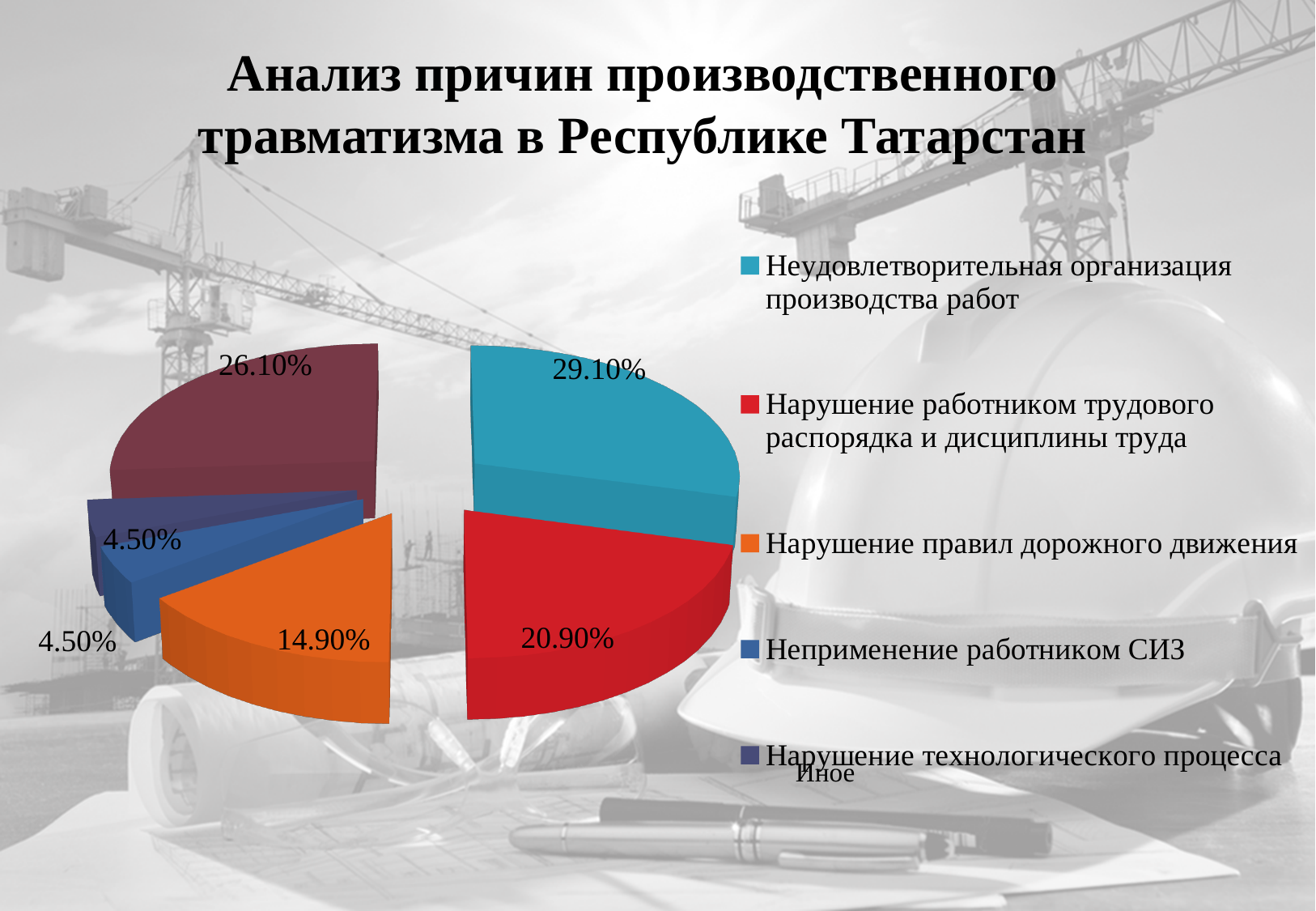
What share does the slice for "Неудовлетворительная организация производства работ" have? 29.10% What is the smallest percentage value shown on the pie chart? 4.50% What share does the slice for "Неприменение работником СИЗ" have? 4.50% What share does the slice for "Нарушение правил дорожного движения" have? 14.90% What kind of chart is shown on the slide? pie chart Which category has the largest slice of the pie? Неудовлетворительная организация производства работ What share does the slice for "Нарушение работником трудового распорядка и дисциплины труда" have? 20.90% What colour is the slice for "Нарушение правил дорожного движения"? orange What is the combined share of the two largest slices, 29.10% and 26.10%? 55.20% What is the difference between the shares for "Неудовлетворительная организация производства работ" and "Нарушение работником трудового распорядка и дисциплины труда"? 8.20% How many slices does the pie chart have? 6 Which is larger: the slice for "Нарушение правил дорожного движения" or the slice for "Неприменение работником СИЗ"? Нарушение правил дорожного движения